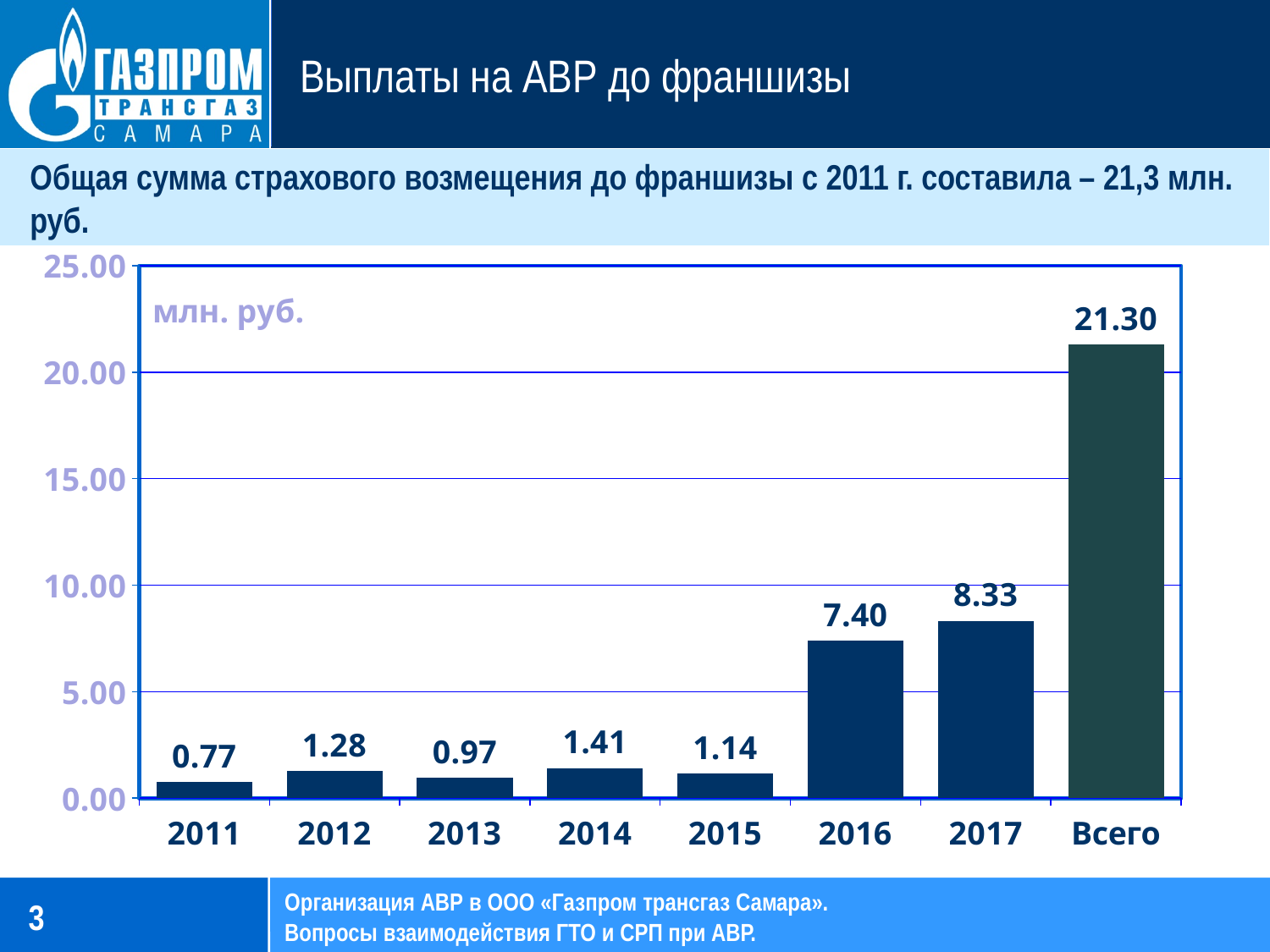
What kind of chart is shown on the slide? bar chart Which year from 2011 to 2017 has the highest value? 2017 What is the value for 2016? 7.40 Is the value for 2017 greater or less than 10.00? less Which category has the lowest value? 2011 Do the values rise or fall from 2015 to 2017? rise Which is larger, the value for 2014 or the value for 2012? 2014 What unit is indicated inside the chart area? млн. руб. What is the value for 2013? 0.97 How many bars are shown in the chart? 8 What is the difference between the values for 2017 and 2016? 0.93 What is the value shown for Всего? 21.30